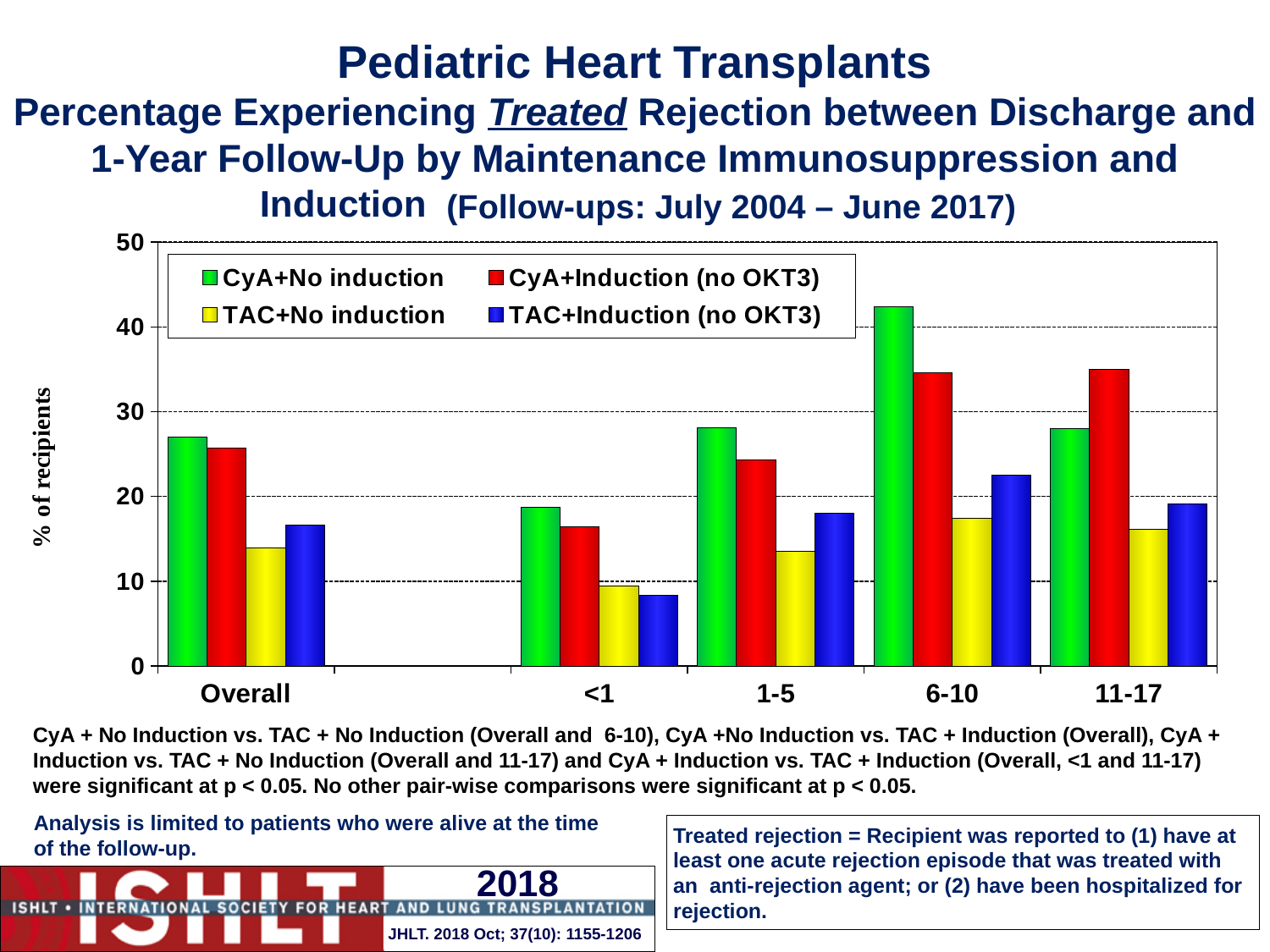
How many age-group categories are shown on the x axis? 4 Is the value for CyA+No induction in the 6-10 group greater or less than 40? greater How many series does the legend list? 4 In which age group is the CyA+No induction value highest? 6-10 Is the value for CyA+Induction (no OKT3) in the 11-17 group greater or less than 30? greater Is the value for CyA+No induction in the Overall group greater or less than 30? less In which age group is the TAC+Induction (no OKT3) value lowest? <1 What kind of chart is shown on the slide? bar chart In the 11-17 group, which is larger: CyA+No induction or CyA+Induction (no OKT3)? CyA+Induction (no OKT3) What is the label on the y axis? % of recipients